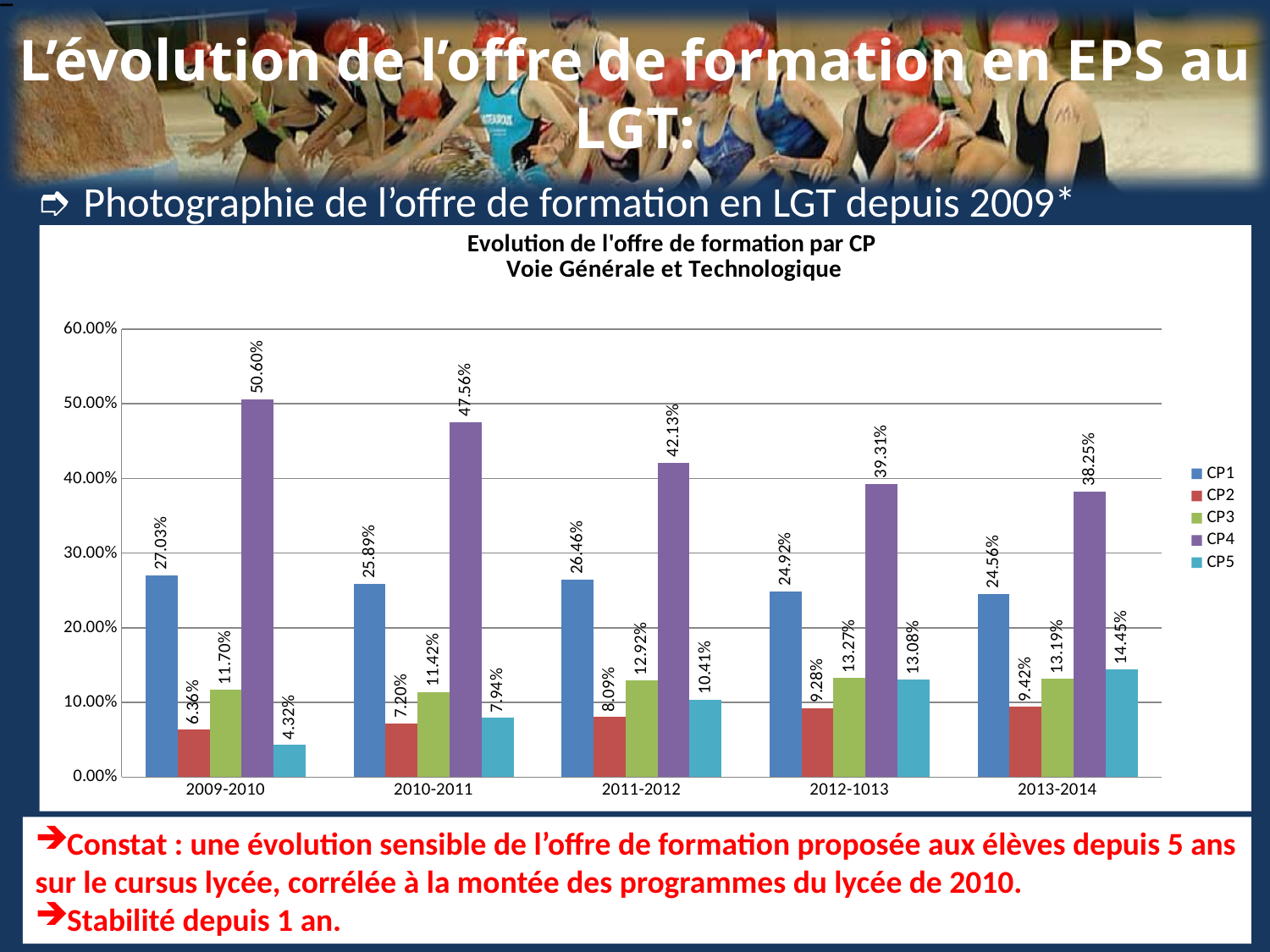
What is the difference between the CP4 values for 2009-2010 and 2013-2014? 12.35% How many year categories are shown on the x axis? 5 What is the title of the chart? Evolution de l'offre de formation par CP Voie Générale et Technologique Do the CP4 values rise or fall from 2009-2010 to 2013-2014? Fall What kind of chart is shown on the slide? Bar chart How many series does the legend list? 5 Which is larger in 2012-1013: CP3 or CP5? CP3 Which series has the highest value in 2010-2011? CP4 What is the value for CP4 in 2009-2010? 50.60% What is the value for CP5 in 2013-2014? 14.45% Which series has the lowest value in 2009-2010? CP5 What is the value for CP2 in 2011-2012? 8.09%